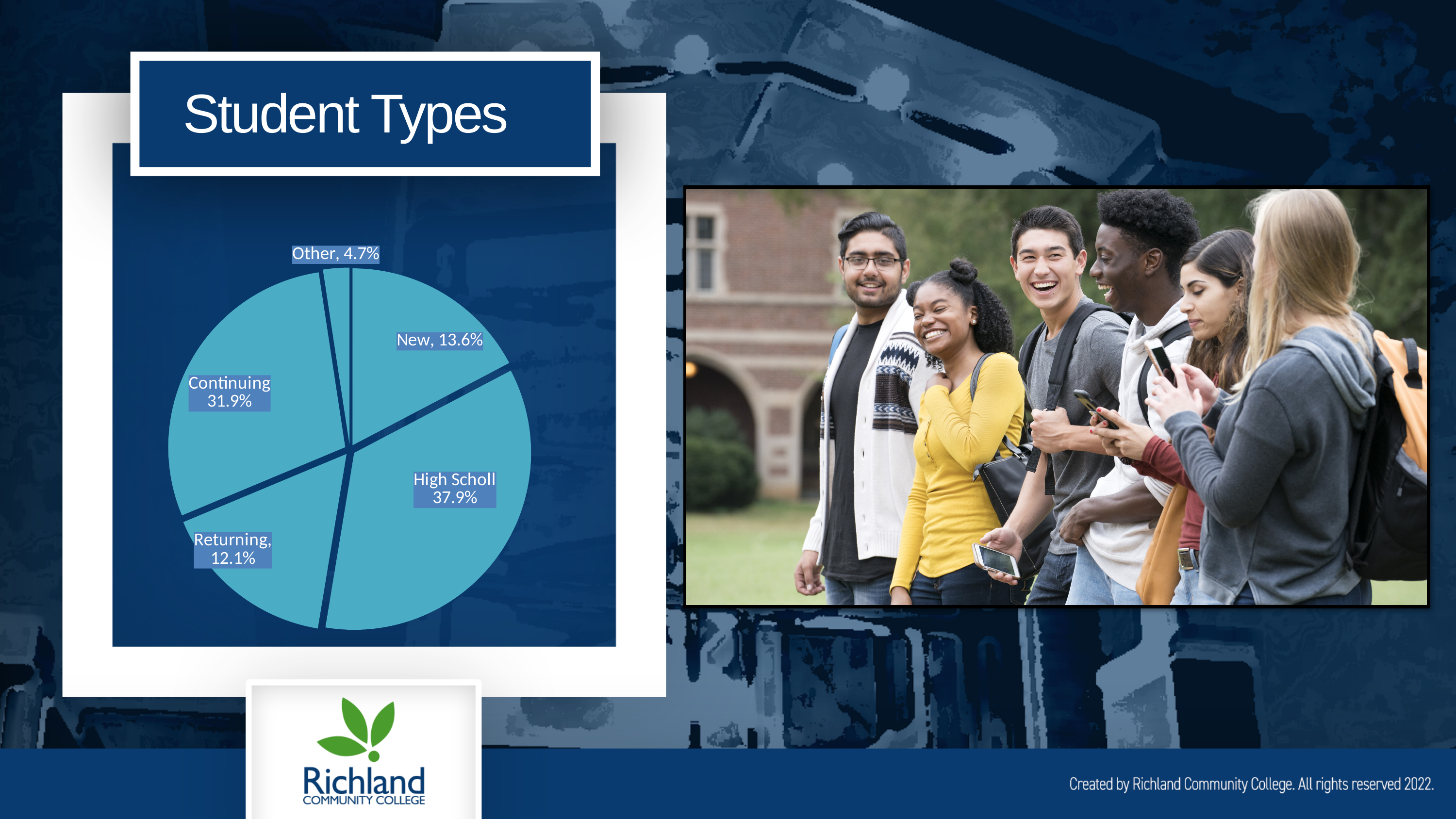
What is the title of the chart? Student Types What share of students are High Scholl students according to the pie chart? 37.9% What percentage is shown for Returning students? 12.1% Which student type has the smallest share of the pie? Other What percentage of students are Continuing students? 31.9% What is the difference in percentage points between High Scholl and Continuing students? 6.0 Which is larger, the New slice or the Returning slice? New What kind of chart is shown on the slide? Pie chart What is the value shown for the New slice? 13.6% Which student type has the largest share of the pie? High Scholl What is the value of the Other slice? 4.7% How many slices does the pie chart have? 5